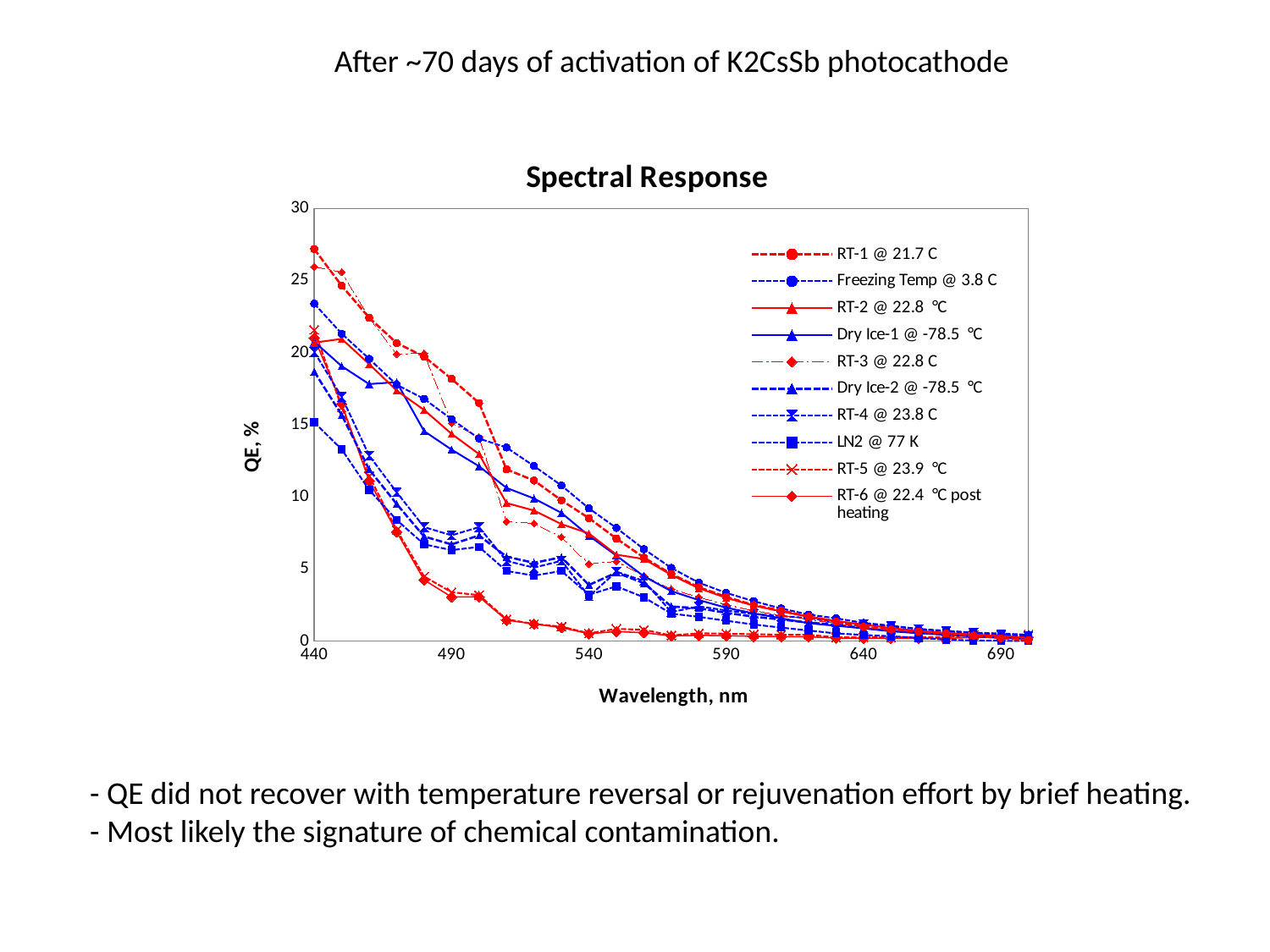
Which series has the lowest QE at 440 nm? LN2 @ 77 K Which series has the highest QE at 440 nm? RT-1 @ 21.7 C Is the QE value for Freezing Temp @ 3.8 C at 440 nm greater or less than 20? greater Do the QE values rise or fall as wavelength increases along the x axis? fall What kind of chart is shown on the slide? line chart Is the QE value for Dry Ice-1 @ -78.5 °C at 490 nm greater or less than 10? greater How many series does the legend of the Spectral Response chart list? 10 What is the title of the chart? Spectral Response Is the QE value for RT-1 @ 21.7 C at 440 nm greater or less than 25? greater At 440 nm, which has the larger QE: RT-1 @ 21.7 C or LN2 @ 77 K? RT-1 @ 21.7 C What is the label of the x axis of the chart? Wavelength, nm